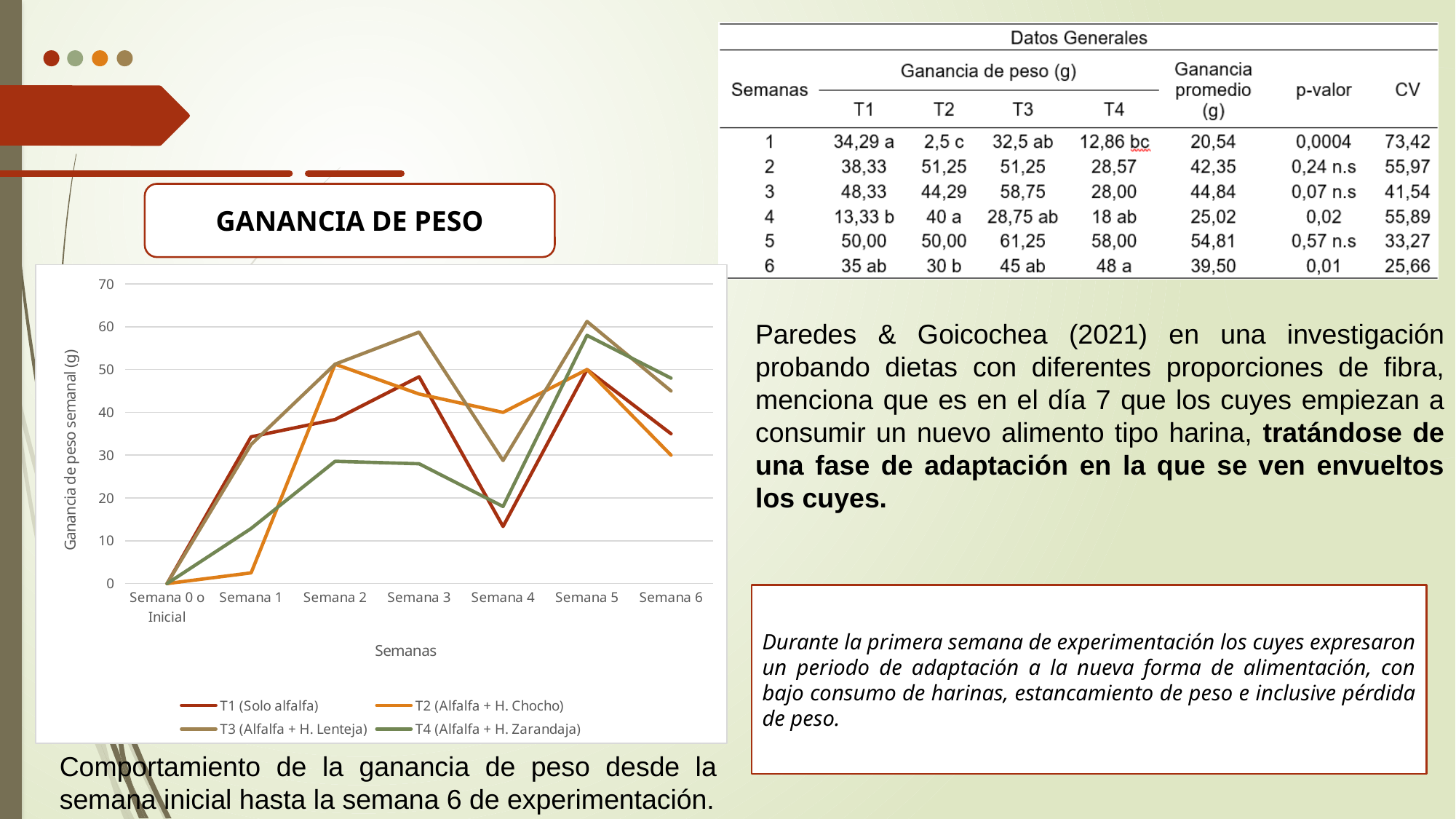
Does the value for T1 (Solo alfalfa) rise or fall from Semana 3 to Semana 4? fall How many series does the chart legend list? 4 Is the value for T3 (Alfalfa + H. Lenteja) at Semana 3 greater or less than 50? greater Is the value for T2 (Alfalfa + H. Chocho) at Semana 6 greater or less than 40? less Which series has the highest value at Semana 5? T3 (Alfalfa + H. Lenteja) What is the value for T1 (Solo alfalfa) at Semana 0 o Inicial? 0 Is the value for T1 (Solo alfalfa) at Semana 4 greater or less than 20? less Which series has the lowest value at Semana 1? T2 (Alfalfa + H. Chocho) At Semana 4, which is larger: T2 (Alfalfa + H. Chocho) or T4 (Alfalfa + H. Zarandaja)? T2 (Alfalfa + H. Chocho) How many week categories are shown on the x axis of the chart? 7 What kind of chart is shown on the slide? line chart What is the value for T1 (Solo alfalfa) at Semana 5? 50